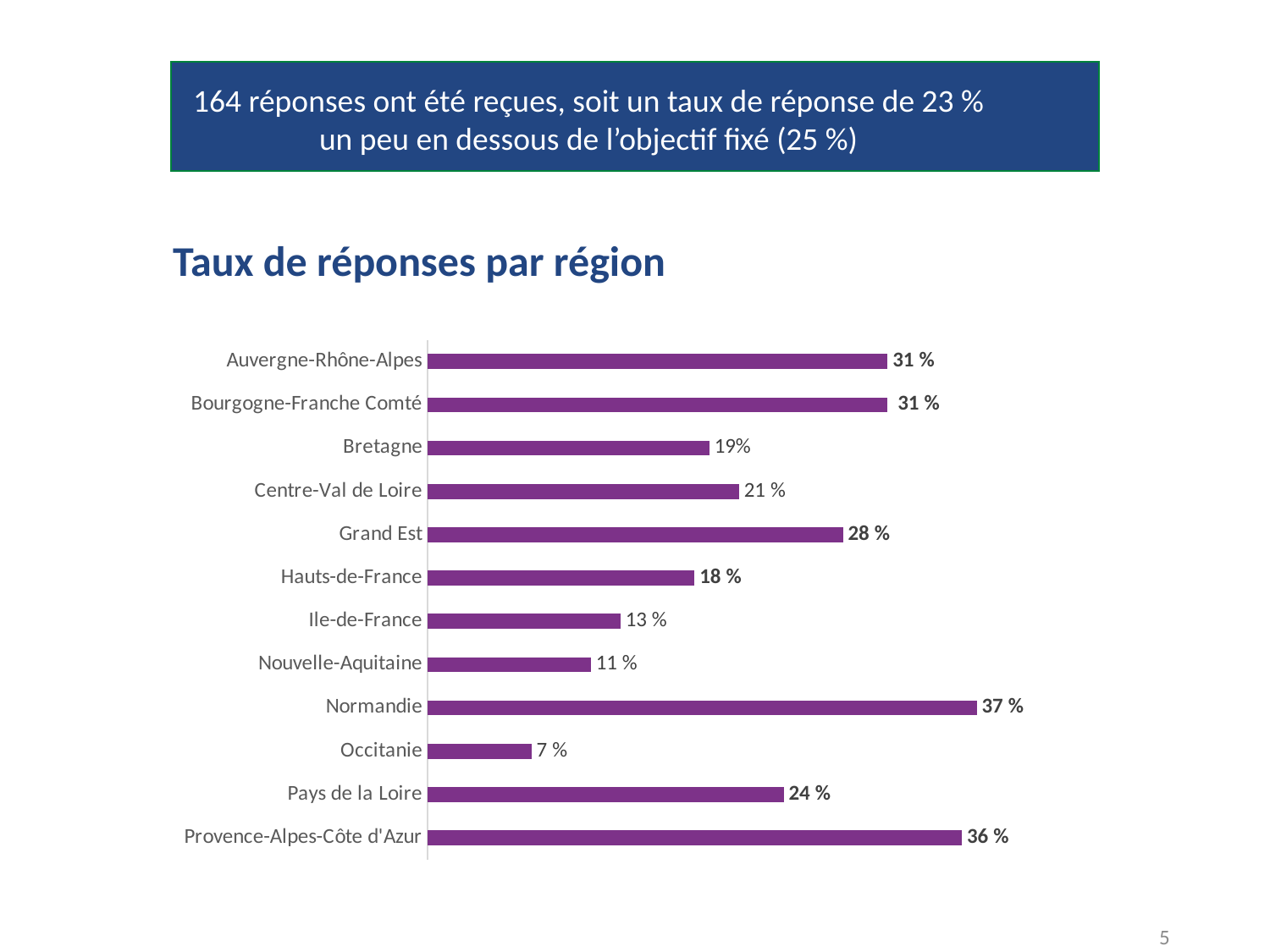
What is the response rate for Occitanie? 7 % What is the title of the chart? Taux de réponses par région Which region has the highest response rate? Normandie What is the response rate for Bretagne? 19% What is the response rate for Grand Est? 28 % Which region has the lowest response rate? Occitanie What kind of chart is shown on the slide? Bar chart What is the response rate for Normandie? 37 % What is the difference between the response rates of Pays de la Loire and Ile-de-France? 11 % What is the difference between the response rates of Normandie and Provence-Alpes-Côte d'Azur? 1 % Which has a higher response rate, Centre-Val de Loire or Hauts-de-France? Centre-Val de Loire How many regions are shown in the chart? 12